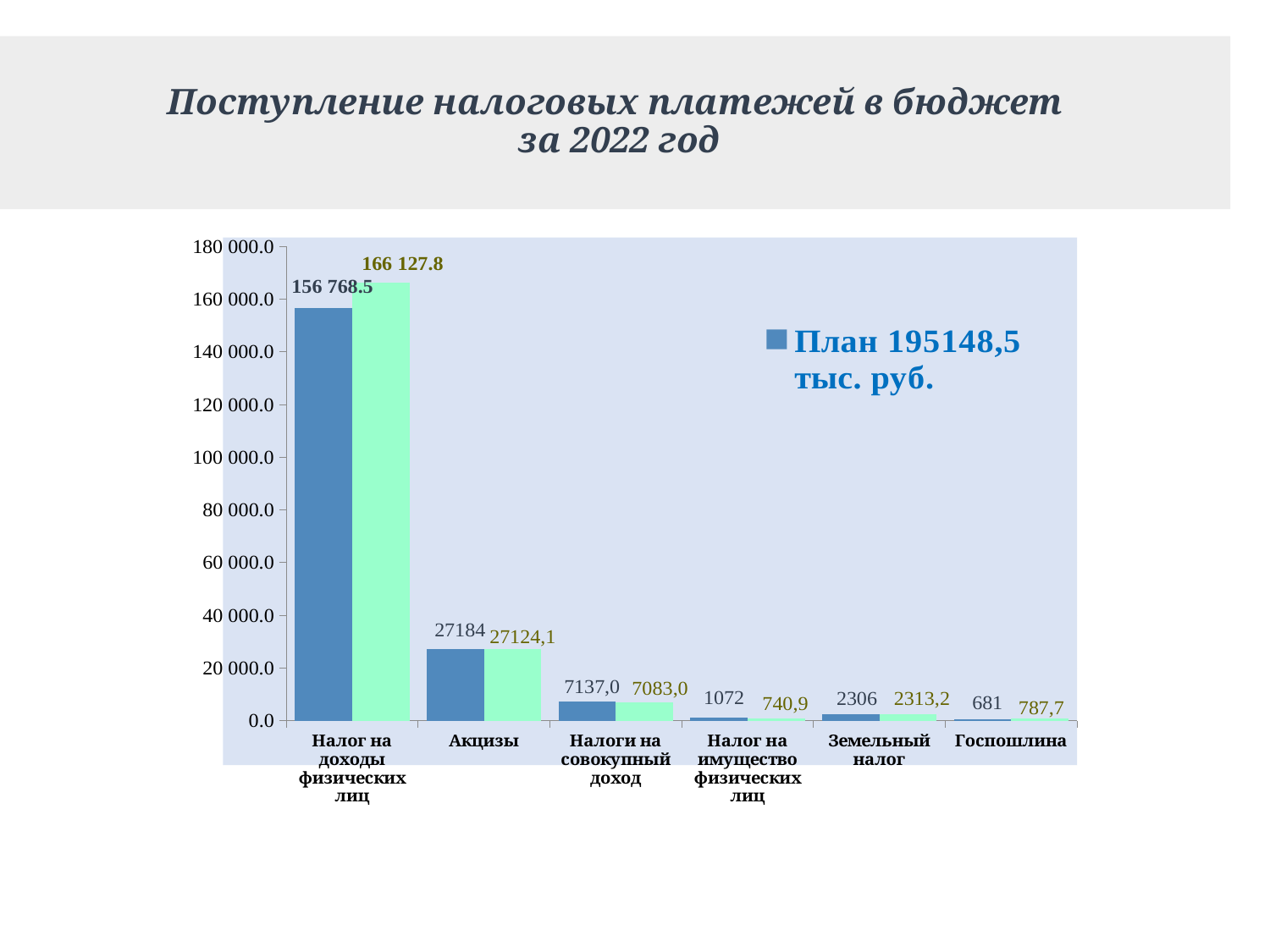
How many categories are shown on the x axis? 6 Which category has the highest blue (План) bar? Налог на доходы физических лиц What kind of chart is shown on the slide? bar chart Which category has the lowest green bar? Налог на имущество физических лиц What is the title of the slide? Поступление налоговых платежей в бюджет за 2022 год What is the value of the blue (План) bar for Акцизы? 27184 For Налог на имущество физических лиц, which is larger: the blue (План) bar or the green bar? the blue (План) bar What is the value of the green bar for Налог на доходы физических лиц? 166 127.8 What is the value of the blue (План) bar for Налог на доходы физических лиц? 156 768.5 What is the difference between the blue and green bars for Налог на имущество физических лиц? 331,1 What is the difference between the green and blue bars for Госпошлина? 106,7 What is the value of the green bar for Госпошлина? 787,7